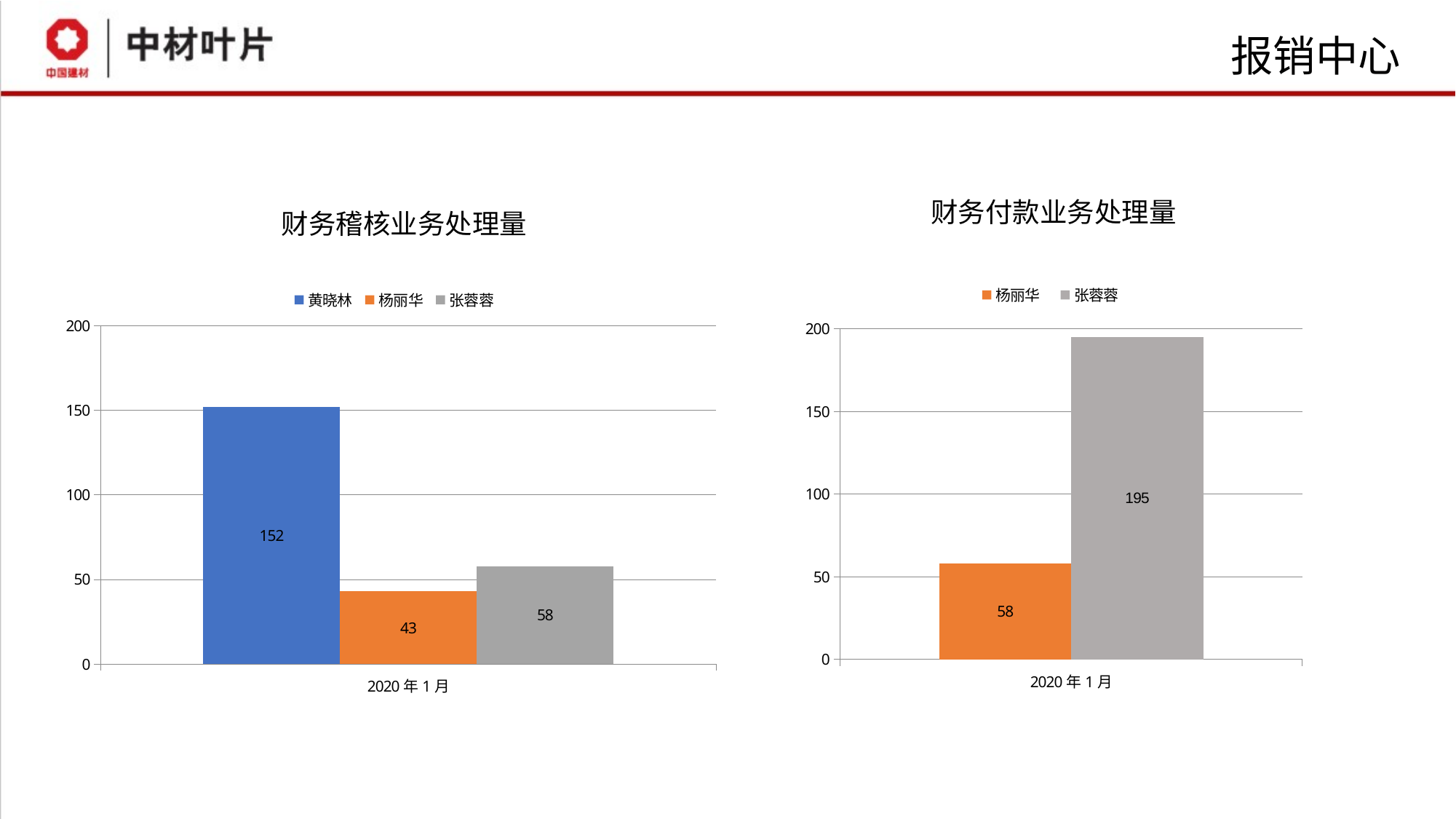
In the 财务付款业务处理量 chart, which is larger, the value for 杨丽华 or 张蓉蓉? 张蓉蓉 How many series does the legend of the 财务稽核业务处理量 chart list? 3 In the 财务稽核业务处理量 chart, what is the difference between the values for 黄晓林 and 张蓉蓉? 94 In the 财务稽核业务处理量 chart, which series has the lowest value? 杨丽华 How many series does the legend of the 财务付款业务处理量 chart list? 2 In the 财务稽核业务处理量 chart, what is the value for 黄晓林? 152 In the 财务付款业务处理量 chart, what is the value for 张蓉蓉? 195 In the 财务付款业务处理量 chart, what is the difference between the values for 张蓉蓉 and 杨丽华? 137 In the 财务付款业务处理量 chart, what is the value for 杨丽华? 58 In the 财务稽核业务处理量 chart, what is the value for 杨丽华? 43 What kind of chart is the 财务付款业务处理量 chart? Bar chart In the 财务稽核业务处理量 chart, which series has the highest value? 黄晓林